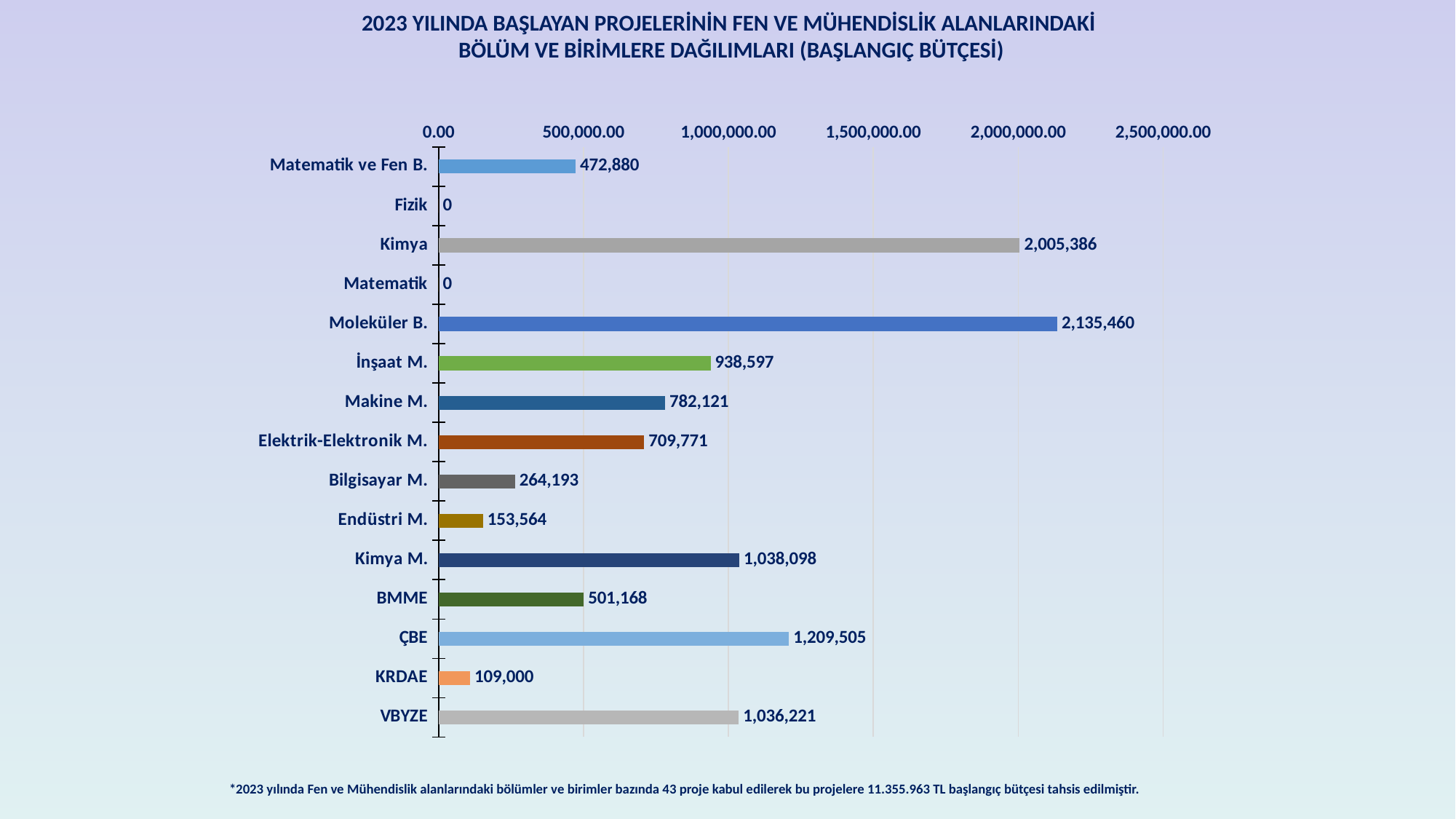
How many categories have a value of 0? 2 What is the value for KRDAE? 109,000 How many categories are shown on the chart? 15 What is the value for Elektrik-Elektronik M.? 709,771 What is the difference between the values for Moleküler B. and Kimya? 130,074 Which category has the highest value? Moleküler B. What is the value for Moleküler B.? 2,135,460 What kind of chart is shown on the slide? Bar chart What is the difference between the values for ÇBE and BMME? 708,337 Is the value for ÇBE greater or less than 1,000,000.00? greater Which has a larger value, İnşaat M. or Makine M.? İnşaat M. Is the value for Bilgisayar M. greater or less than 500,000.00? less